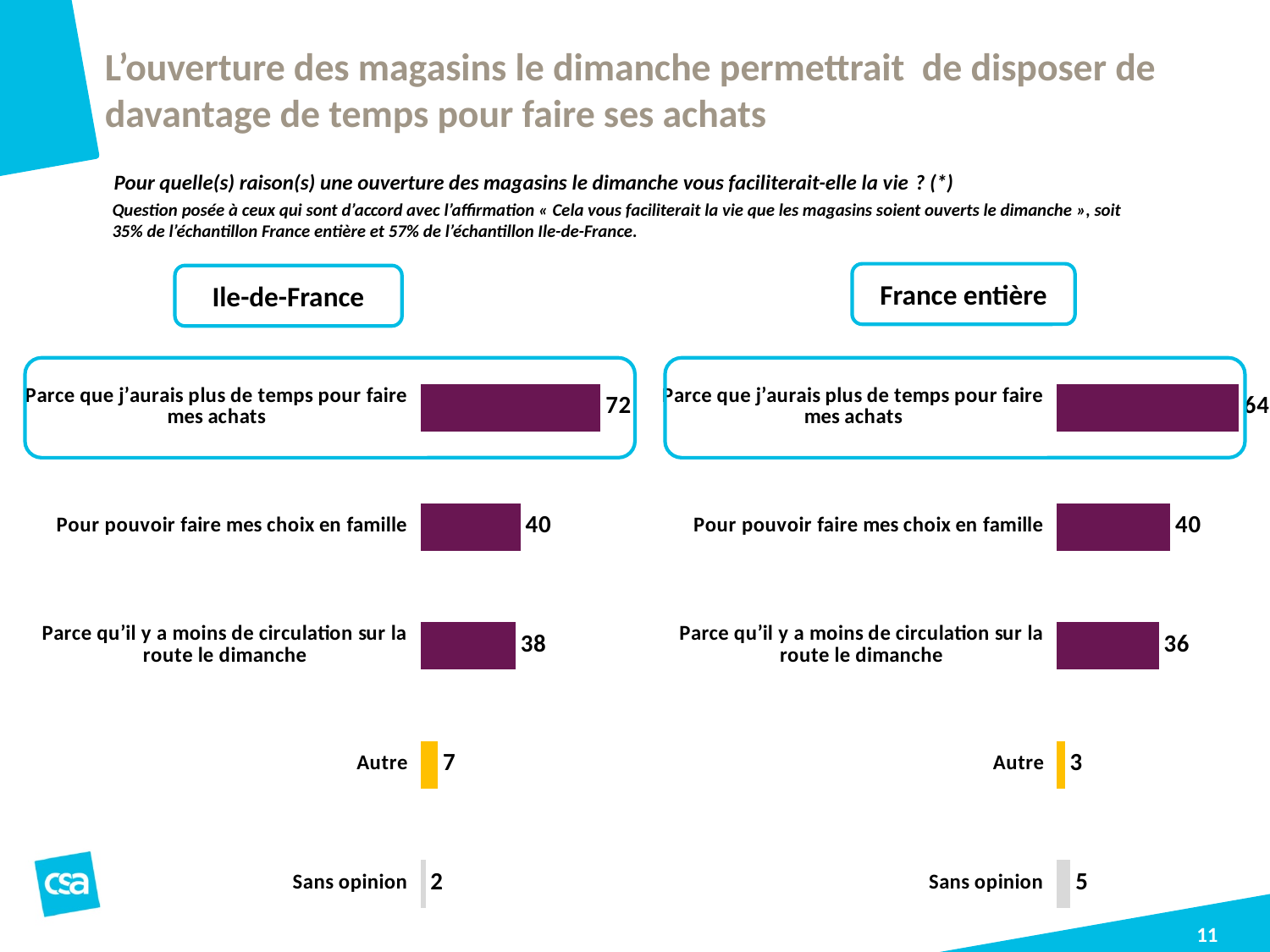
What type of chart is the France entière chart? Bar chart How many categories are shown in the Ile-de-France chart? 5 In the Ile-de-France chart, what colour is the bar for "Autre"? Yellow In the France entière chart, what is the difference between "Pour pouvoir faire mes choix en famille" and "Parce qu'il y a moins de circulation sur la route le dimanche"? 4 Which chart shows a larger value for "Parce qu'il y a moins de circulation sur la route le dimanche", Ile-de-France or France entière? Ile-de-France In the France entière chart, what is the value for "Pour pouvoir faire mes choix en famille"? 40 In the Ile-de-France chart, what is the value for "Parce que j'aurais plus de temps pour faire mes achats"? 72 In the France entière chart, which category has the highest value? Parce que j'aurais plus de temps pour faire mes achats In the Ile-de-France chart, what is the difference between "Parce que j'aurais plus de temps pour faire mes achats" and "Pour pouvoir faire mes choix en famille"? 32 In the Ile-de-France chart, what is the value for "Autre"? 7 In the France entière chart, what is the value for "Sans opinion"? 5 In the Ile-de-France chart, which category has the lowest value? Sans opinion